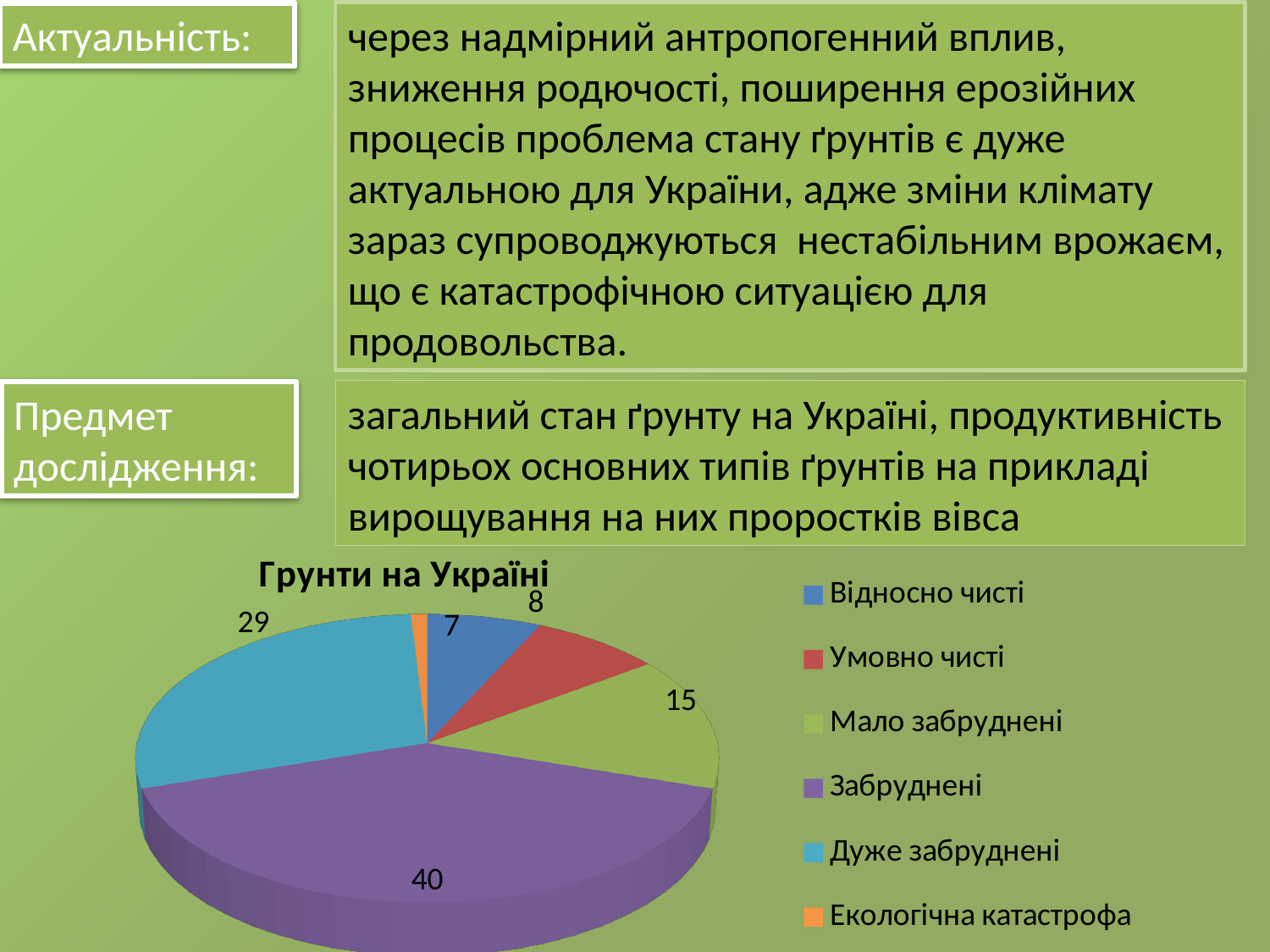
What is the title of the chart? Грунти на Україні Which is larger, the value for Мало забруднені or the value for Умовно чисті? Мало забруднені What type of chart is shown on the slide? Pie chart What is the value for Мало забруднені in the chart? 15 How many categories does the legend of the chart list? 6 What is the value for Дуже забруднені in the chart? 29 What is the value for Відносно чисті in the chart? 7 Which category has the largest slice in the chart? Забруднені Which category has the smallest slice in the chart? Екологічна катастрофа What is the value for Забруднені in the chart? 40 What is the value for Умовно чисті in the chart? 8 What is the difference between the values for Забруднені and Дуже забруднені? 11